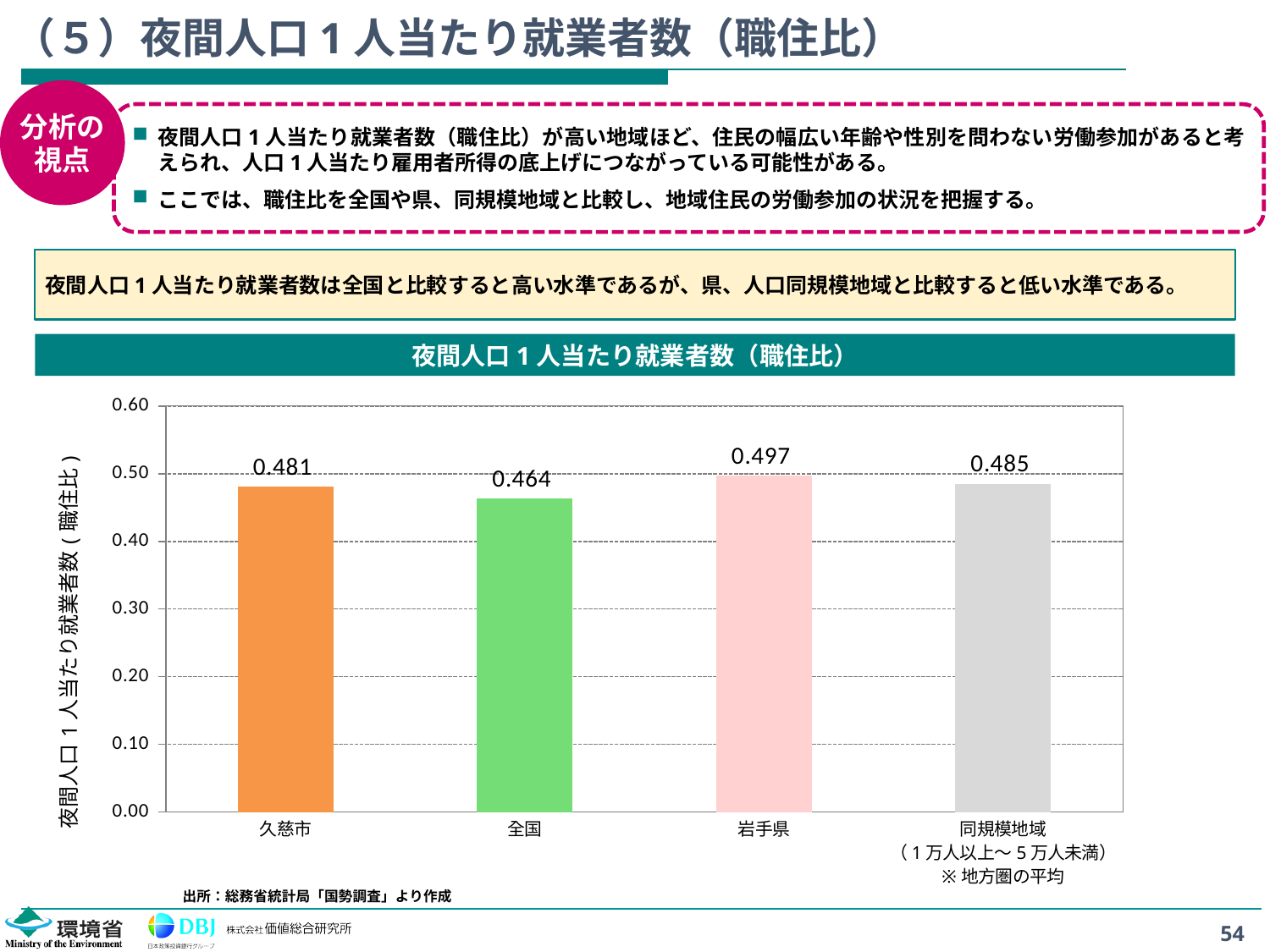
What is the title of the chart? 夜間人口１人当たり就業者数（職住比） What is the difference between the values for 久慈市 and 全国? 0.017 How many categories are shown in the chart? 4 What is the value for 久慈市? 0.481 What is the value for 同規模地域? 0.485 What is the value for 全国? 0.464 Which is larger, the value for 久慈市 or the value for 全国? 久慈市 Which category has the lowest value? 全国 What is the value for 岩手県? 0.497 What kind of chart is shown on the slide? Bar chart What is the difference between the values for 岩手県 and 全国? 0.033 Which category has the highest value? 岩手県